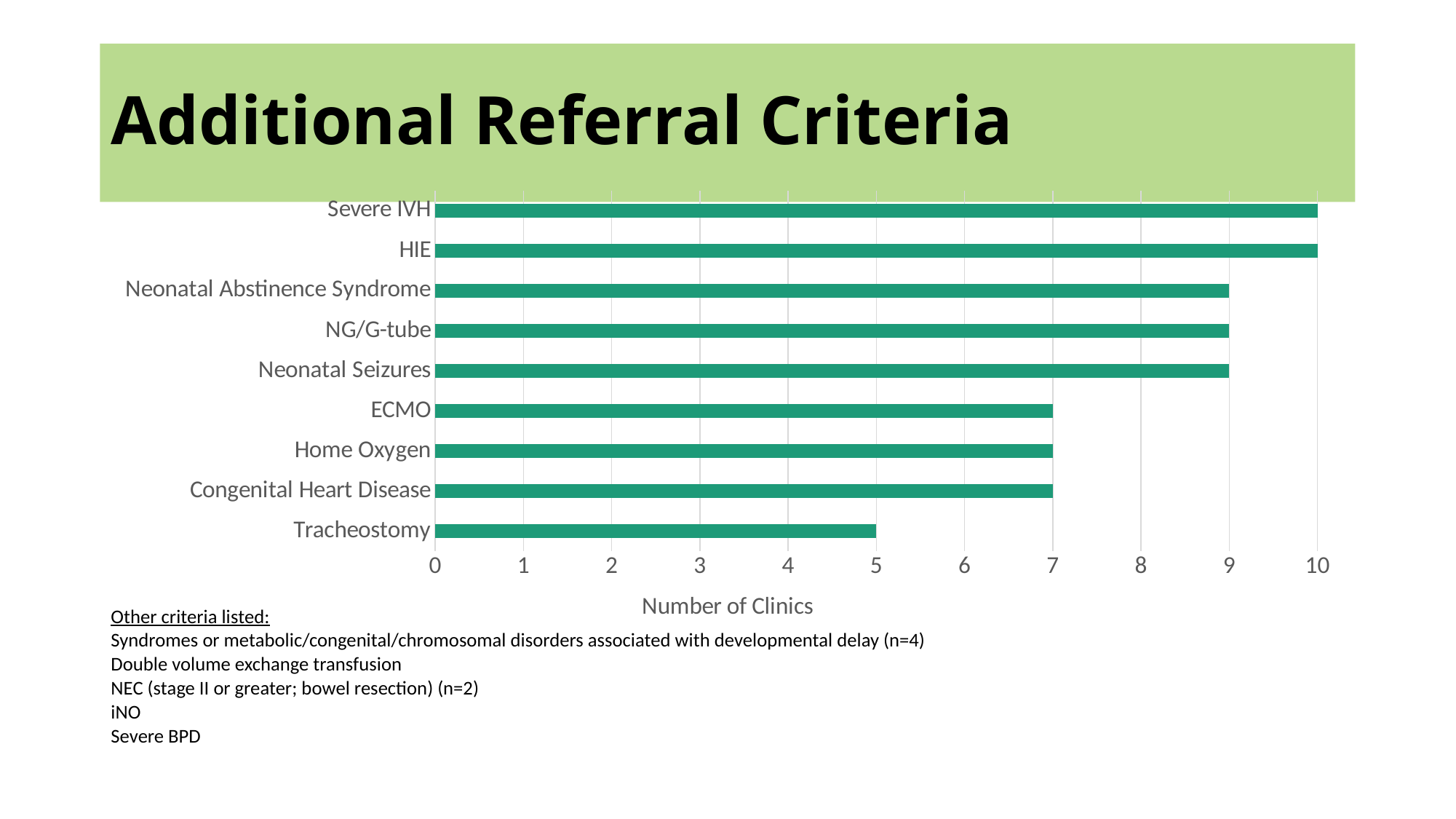
What is the number of clinics for ECMO? 7 What is the difference in number of clinics between Severe IVH and Tracheostomy? 5 Which has more clinics, ECMO or Neonatal Seizures? Neonatal Seizures What kind of chart is shown on the slide? Bar chart Is the value for Congenital Heart Disease greater or less than 8? less What is the title of the horizontal axis? Number of Clinics What is the number of clinics for Neonatal Abstinence Syndrome? 9 What is the number of clinics for Tracheostomy? 5 How many referral criteria are plotted in the chart? 9 What is the difference in number of clinics between NG/G-tube and Home Oxygen? 2 Which referral criterion has the lowest number of clinics? Tracheostomy What is the number of clinics for HIE? 10